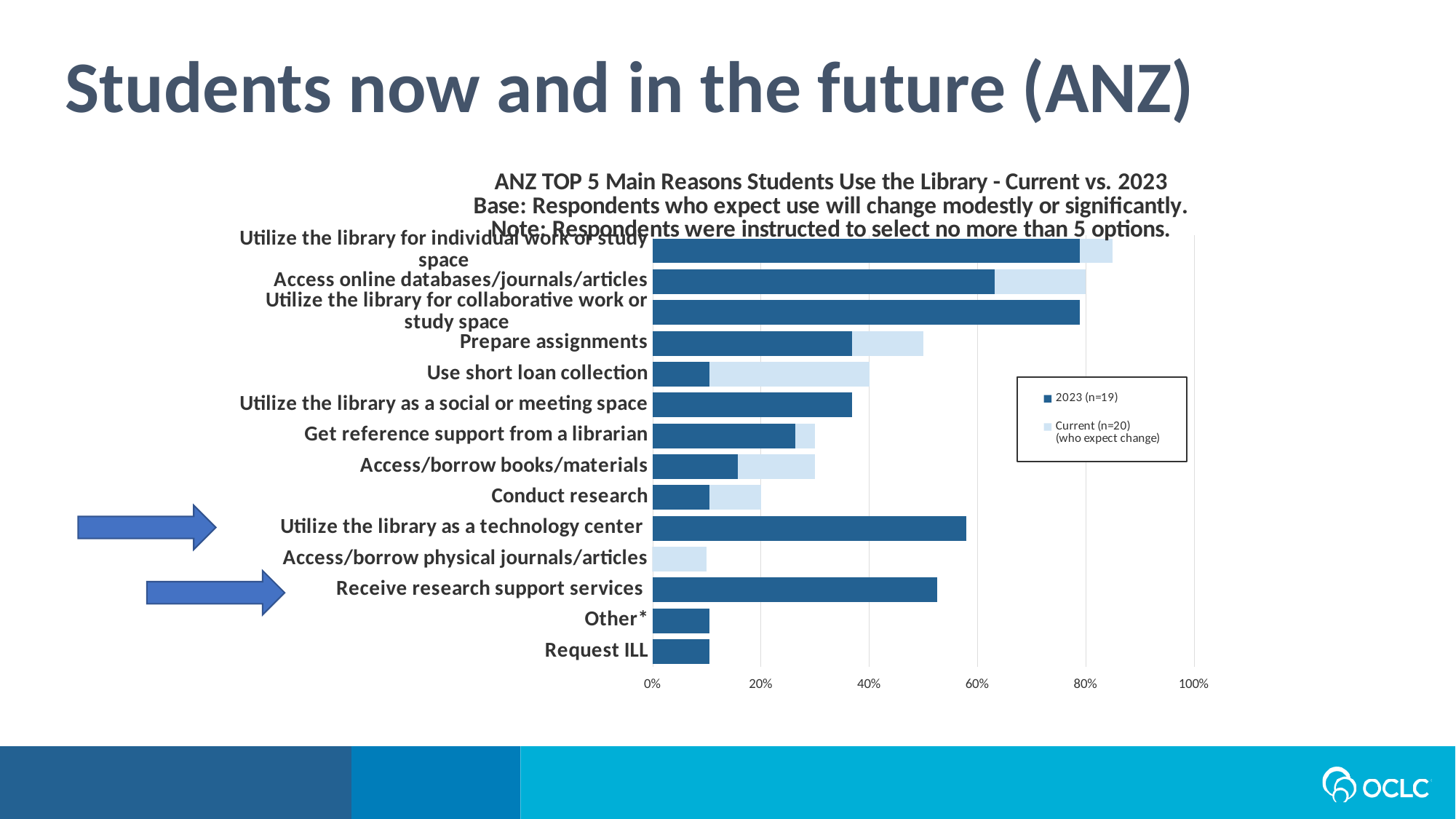
What is the highest percentage tick shown on the horizontal axis? 100% Is the 2023 value for 'Request ILL' greater or less than 20%? less What kind of chart is shown on the slide? bar chart How many categories (reasons) are plotted on the chart? 14 Is the 2023 value for 'Receive research support services' greater or less than 40%? greater Which has the larger 2023 value: 'Utilize the library as a technology center' or 'Utilize the library as a social or meeting space'? Utilize the library as a technology center How many series does the legend list? 2 What is the sample size (n) shown in the legend for the 2023 series? n=19 Is the 2023 value for 'Utilize the library as a technology center' greater or less than 40%? greater Which has the larger 2023 value: 'Access online databases/journals/articles' or 'Prepare assignments'? Access online databases/journals/articles